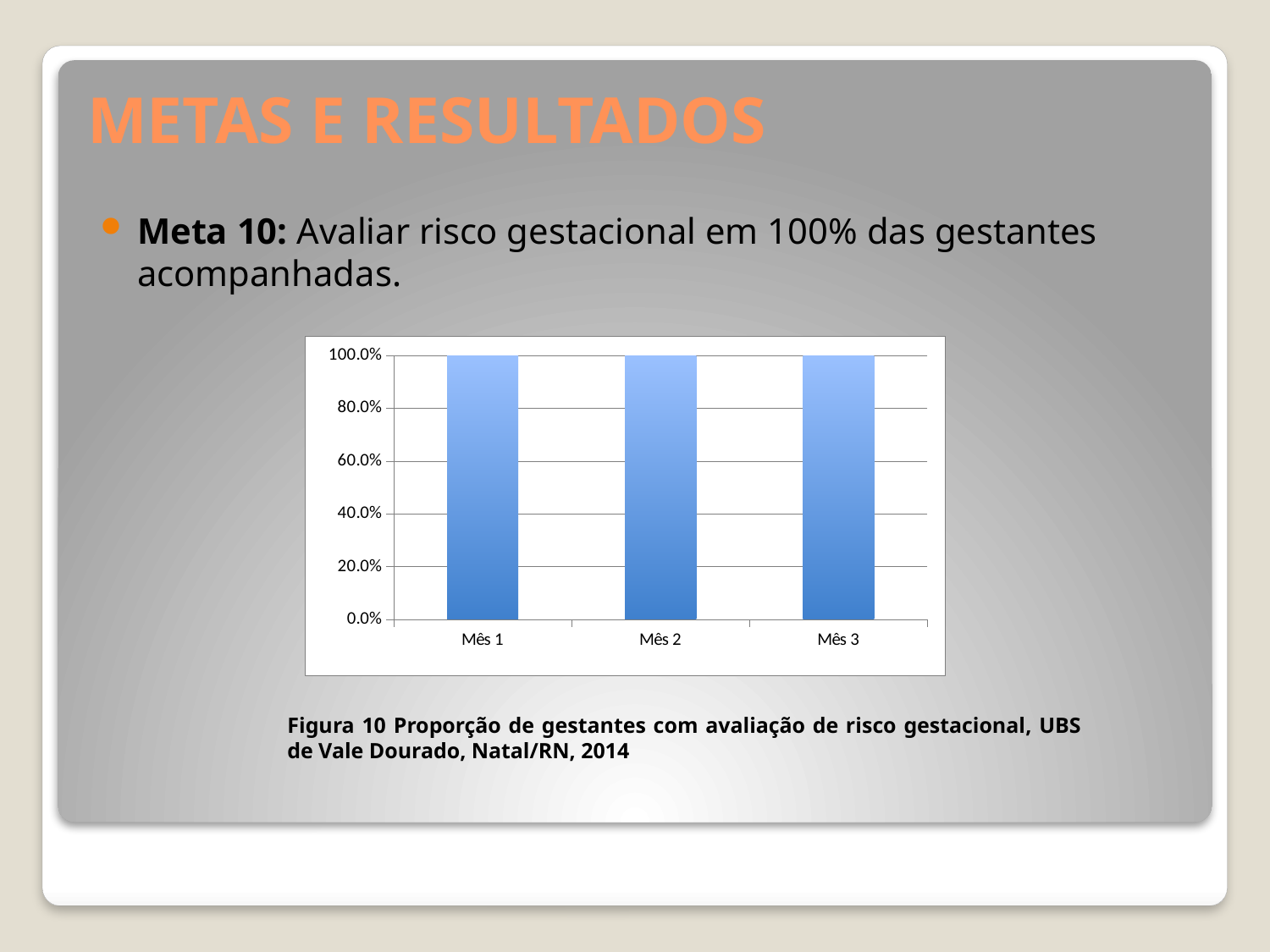
Do the values rise, fall, or stay the same from Mês 1 to Mês 3? stay the same What is the value for Mês 1? 100.0% What is the value for Mês 3? 100.0% What is the figure number given in the caption below the chart? Figura 10 What type of chart is shown on the slide? bar chart What is the value for Mês 2? 100.0% How many categories (months) are plotted on the chart? 3 What is the highest value shown on the y axis? 100.0% Is the value for Mês 2 greater or less than 80.0%? greater What is the difference between the values for Mês 1 and Mês 3? 0.0% Is the value for Mês 3 greater or less than 60.0%? greater